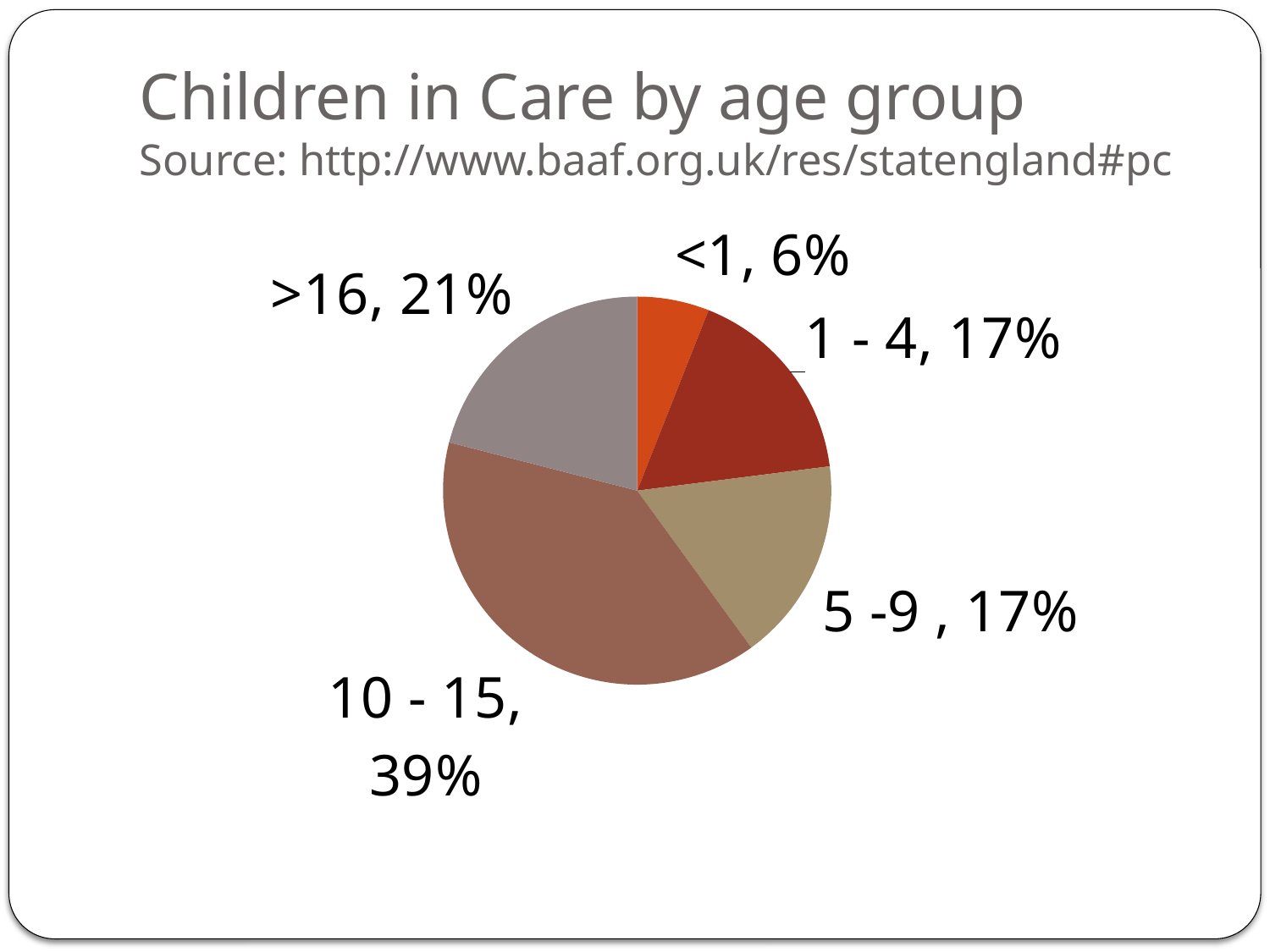
Which age group has the smallest share of children in care? <1 What share of children in care are in the 10 - 15 age group? 39% Which has the larger share, the >16 age group or the 5 -9 age group? >16 Which age group has the largest share of children in care? 10 - 15 What share of children in care are in the <1 age group? 6% What is the title of the chart? Children in Care by age group What share of children in care are in the >16 age group? 21% What is the difference in percentage points between the 10 - 15 and >16 age groups? 18 What kind of chart is shown on the slide? pie chart What is the difference in percentage points between the 1 - 4 and <1 age groups? 11 How many age groups are shown in the pie chart? 5